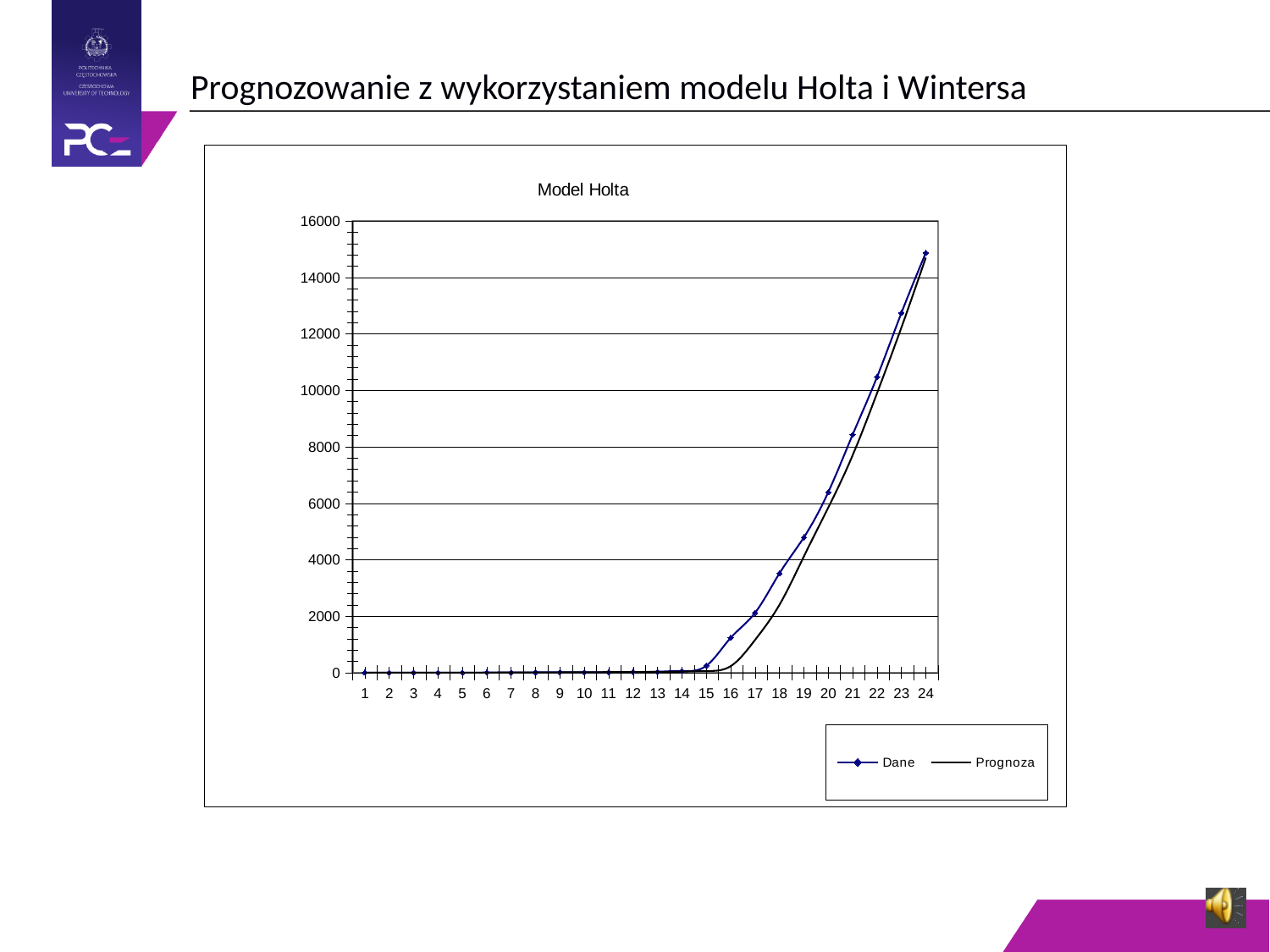
Do the values of the Dane series rise or fall along the x axis? rise What is the title of the chart? Model Holta At point 17, which series has the larger value, Dane or Prognoza? Dane What are the names of the two series in the legend? Dane and Prognoza Is the value of the Dane series at point 10 greater or less than 2000? less Is the value of the Dane series at point 24 greater or less than 14000? greater How many series does the chart legend list? 2 How many points are on the x axis of the chart? 24 Is the value of the Prognoza series at point 21 greater or less than 6000? greater What kind of chart is shown on the slide? line chart At which x-axis point does the Dane series reach its highest value? 24